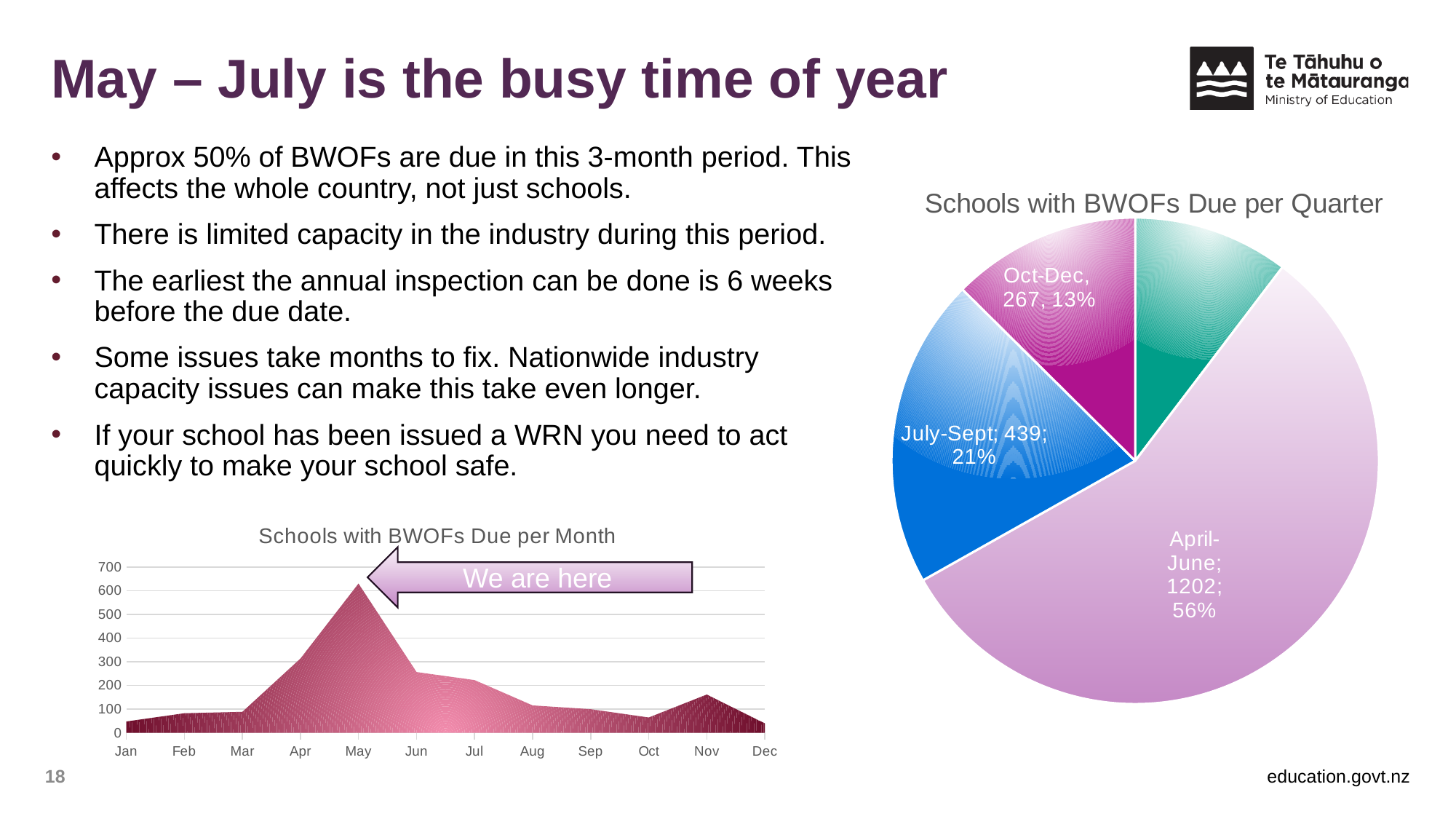
In the 'Schools with BWOFs Due per Month' chart, which month has the highest value? May In the 'Schools with BWOFs Due per Month' chart, is the value for Jan greater or less than 100? less In the 'Schools with BWOFs Due per Quarter' pie chart, which is larger, July-Sept or Oct-Dec? July-Sept In the 'Schools with BWOFs Due per Quarter' pie chart, what is the difference between the April-June and July-Sept values? 763 In the 'Schools with BWOFs Due per Quarter' pie chart, what percentage share does the July-Sept slice have? 21% In the 'Schools with BWOFs Due per Month' chart, is the value for May greater or less than 500? greater In the 'Schools with BWOFs Due per Quarter' pie chart, what is the value for Oct-Dec? 267 How many months are shown on the x axis of the 'Schools with BWOFs Due per Month' chart? 12 In the 'Schools with BWOFs Due per Quarter' pie chart, which labelled quarter has the largest slice? April-June In the 'Schools with BWOFs Due per Quarter' pie chart, how many schools have BWOFs due in April-June? 1202 What kind of chart is 'Schools with BWOFs Due per Month'? Area chart How many slices does the 'Schools with BWOFs Due per Quarter' pie chart have? 4